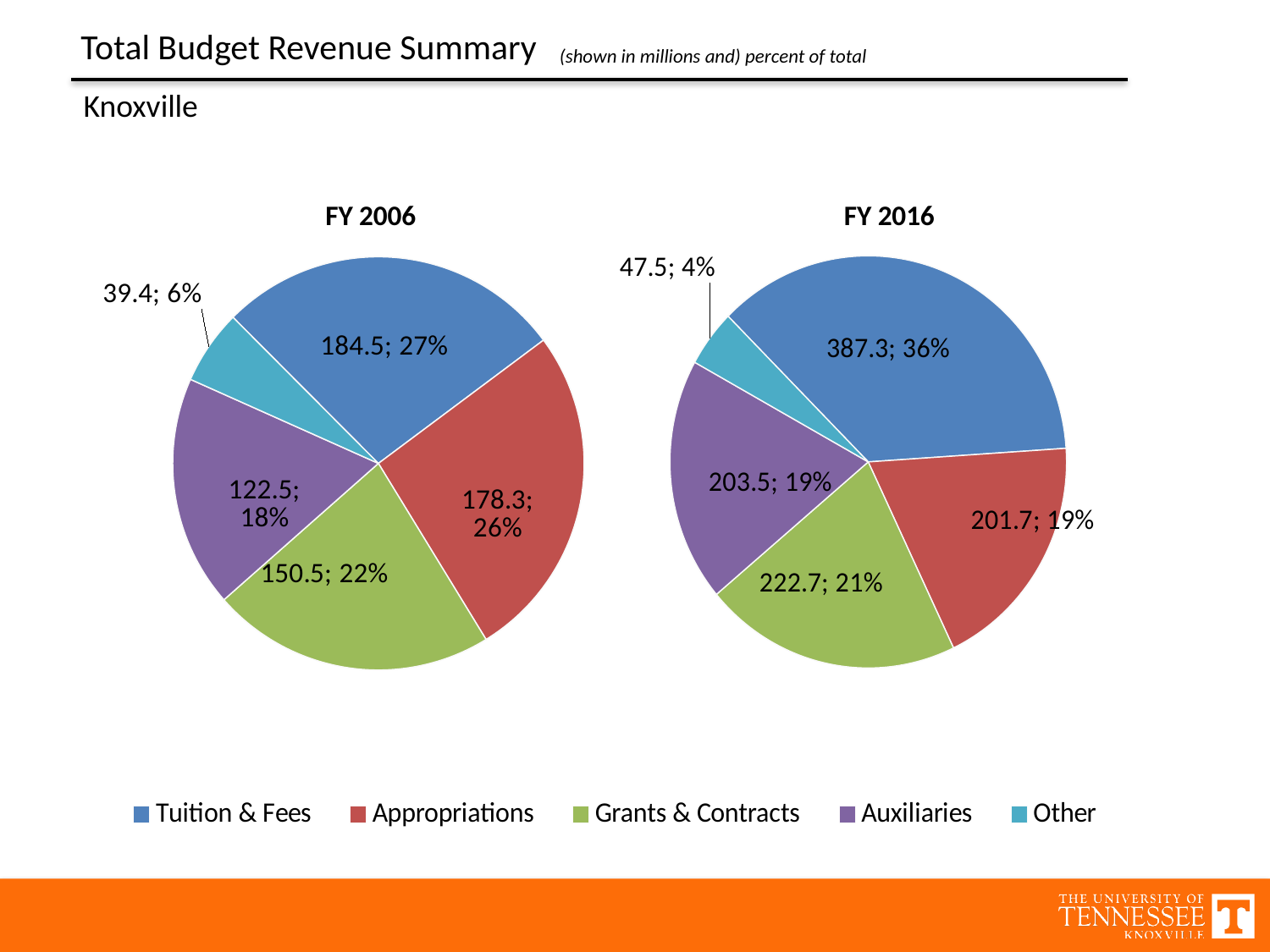
In the FY 2016 pie chart, what is the value shown for Grants & Contracts? 222.7 In the FY 2016 pie chart, which category has the largest slice? Tuition & Fees In the FY 2016 pie chart, what percent of the total is Tuition & Fees? 36% What type of chart is used for FY 2006 and FY 2016? Pie chart In the FY 2006 pie chart, which category has the smallest slice? Other In the FY 2016 pie chart, which is larger: Grants & Contracts or Appropriations? Grants & Contracts In the FY 2006 pie chart, what is the value shown for Tuition & Fees? 184.5 How many slices does the FY 2006 pie chart have? 5 In the FY 2006 pie chart, what percent of the total is Auxiliaries? 18% How many categories does the legend list? 5 What is the difference between the Tuition & Fees value in the FY 2016 chart and the Tuition & Fees value in the FY 2006 chart? 202.8 What colour represents Auxiliaries in the legend? Purple